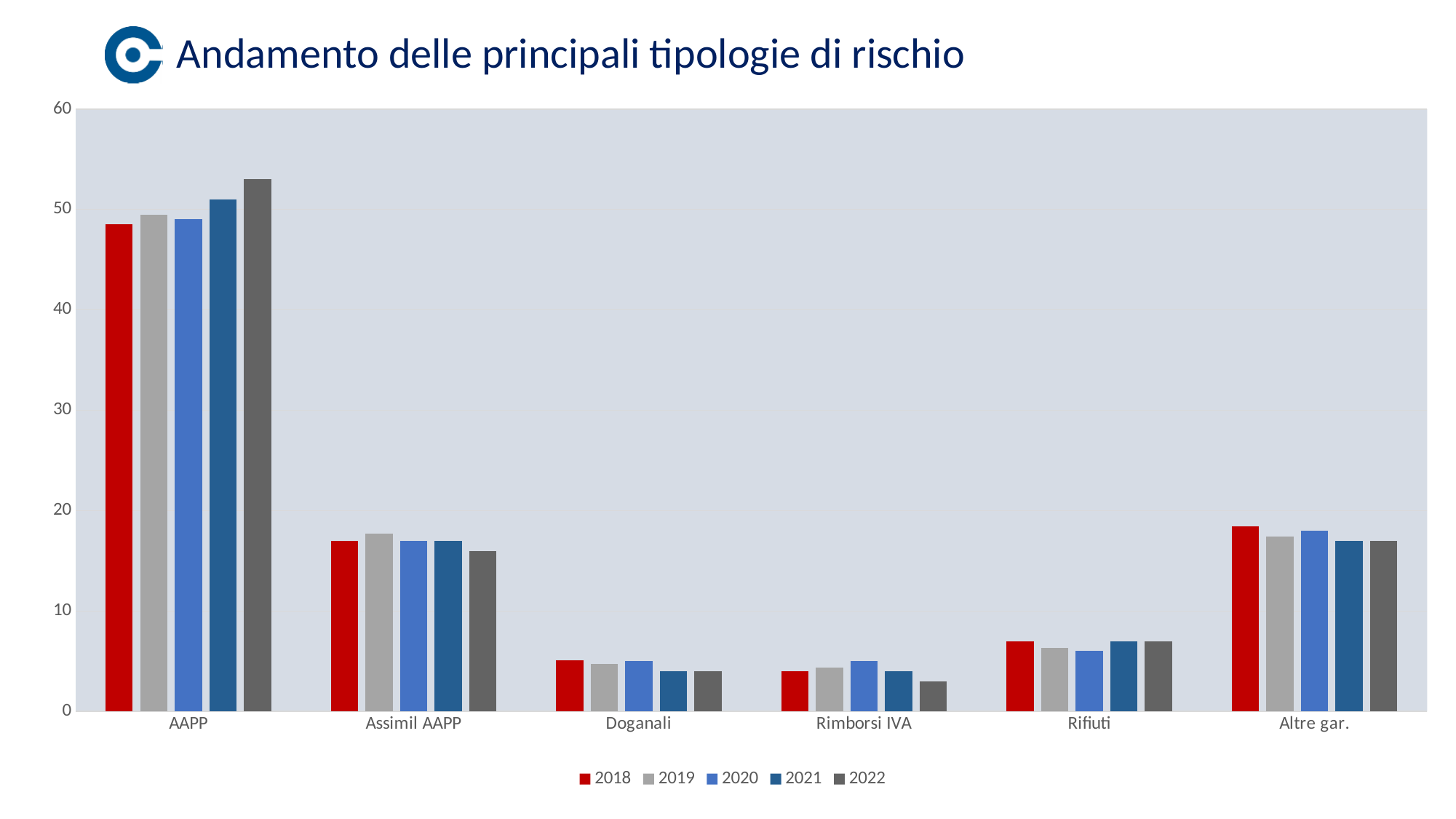
What colour represents the 2018 series in the legend? red Is the value for Altre gar. in 2018 greater or less than 20? less Is the value for AAPP in 2022 greater or less than 50? greater Is the value for AAPP in 2018 greater or less than 50? less What kind of chart is shown on the slide? bar chart Do the AAPP bars generally rise or fall from 2018 to 2022? rise How many categories are shown on the x axis? 6 Which is larger: the 2018 value for Doganali or the 2018 value for Rimborsi IVA? Doganali Which category has the tallest bars? AAPP How many series does the legend list? 5 Within the AAPP category, which year has the highest bar? 2022